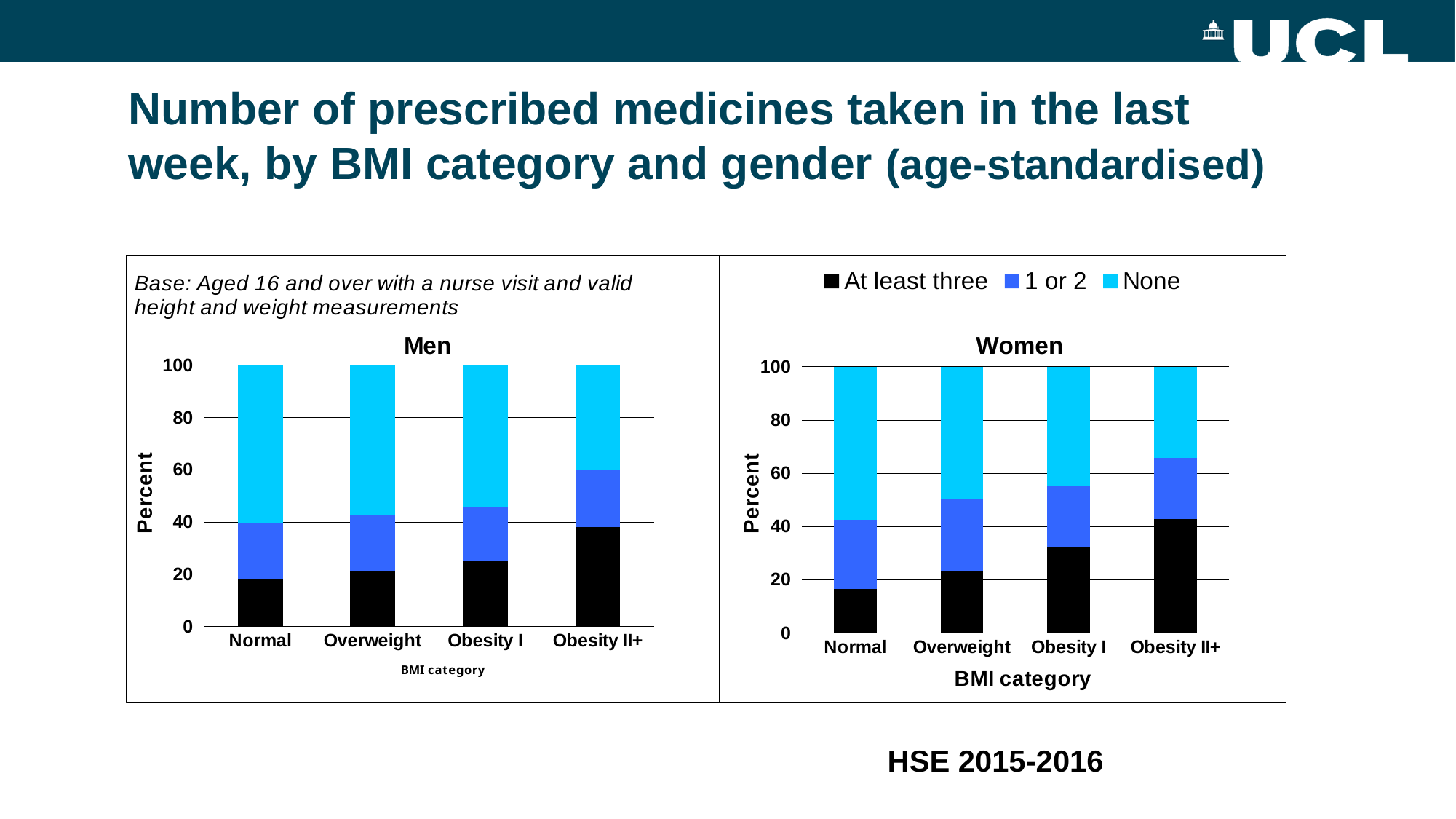
In the Men chart, which BMI category has the largest 'At least three' segment? Obesity II+ What is the total height of each stacked bar in the Women chart? 100 In the Men chart, is the 'At least three' value for Obesity I greater or less than 40? less In the Men chart, which is larger: the 'None' segment for Normal or the 'None' segment for Obesity II+? Normal In the Women chart, which BMI category has the smallest 'At least three' segment? Normal How many series does the legend list? 3 In the Men chart, is the 'At least three' value for Obesity II+ greater or less than 20? greater How many BMI categories are shown on the x axis of the Women chart? 4 What kind of chart is the Men chart? stacked bar chart In the Women chart, is the 'At least three' value for Obesity I greater or less than 20? greater Which colour represents 'None' in the legend? light blue In the Women chart, does the 'At least three' share rise or fall as BMI category increases from Normal to Obesity II+? rise